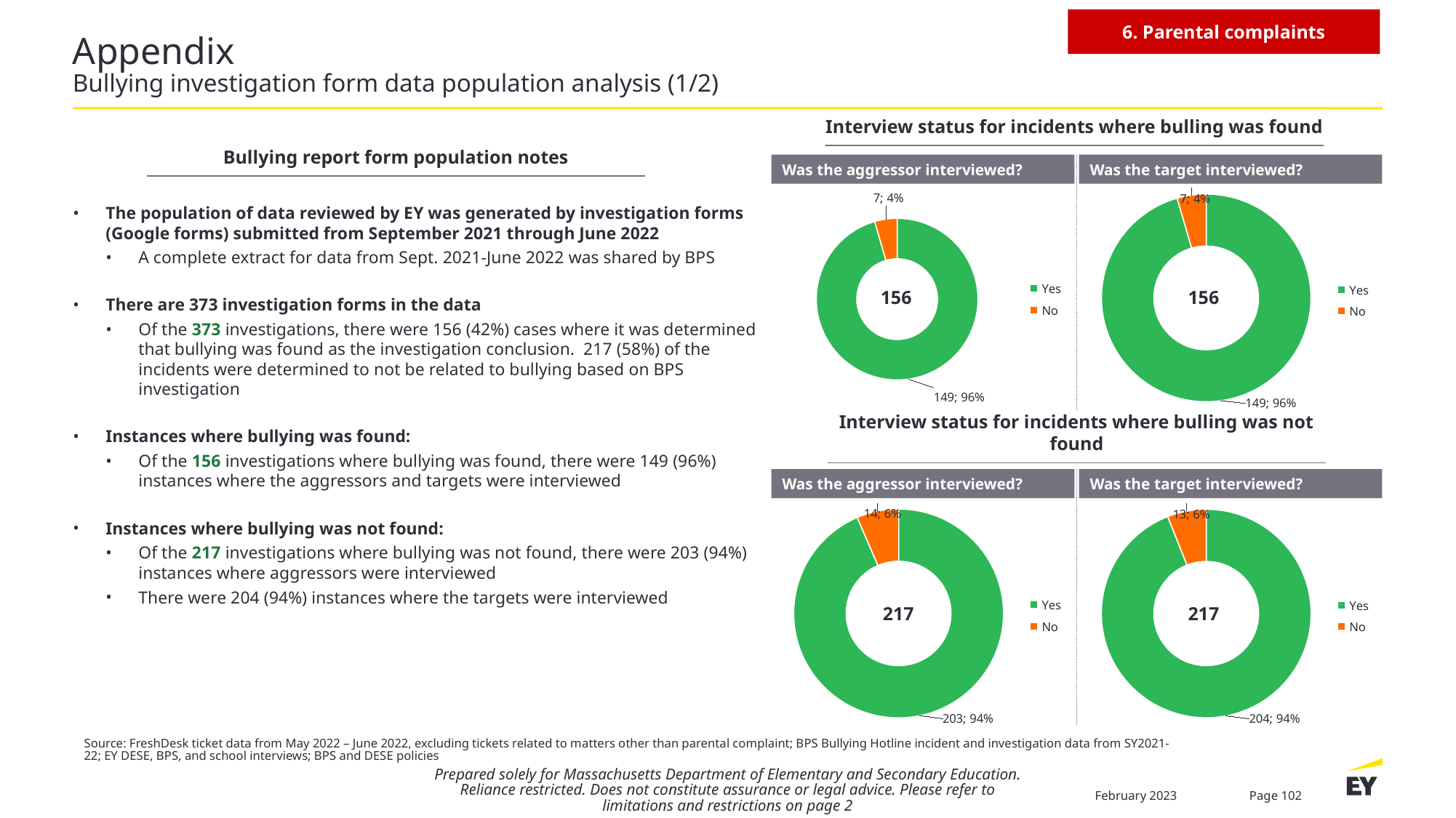
In the 'Was the target interviewed?' chart under 'Interview status for incidents where bulling was not found', what is the value for Yes? 204; 94% In the 'Was the aggressor interviewed?' chart under 'Interview status for incidents where bulling was not found', what is the value for No? 14; 6% What number is shown in the centre of the 'Was the target interviewed?' chart under 'Interview status for incidents where bulling was found'? 156 What number is shown in the centre of the 'Was the aggressor interviewed?' chart under 'Interview status for incidents where bulling was not found'? 217 In the 'Was the aggressor interviewed?' chart under 'Interview status for incidents where bulling was found', what is the value for Yes? 149; 96% What share of the 'Was the target interviewed?' chart under 'Interview status for incidents where bulling was not found' is the Yes slice? 94% In the 'Was the aggressor interviewed?' chart under 'Interview status for incidents where bulling was not found', what is the difference between the Yes count and the No count? 189 In the 'Was the aggressor interviewed?' chart under 'Interview status for incidents where bulling was found', what is the value for No? 7; 4% What type of chart is used for 'Was the aggressor interviewed?' under 'Interview status for incidents where bulling was found'? Donut (pie) chart In the 'Was the target interviewed?' chart under 'Interview status for incidents where bulling was found', which category is the smallest? No In the 'Was the aggressor interviewed?' chart under 'Interview status for incidents where bulling was not found', which category is the largest? Yes In the 'Was the target interviewed?' chart under 'Interview status for incidents where bulling was not found', what is the value for No? 13; 6%